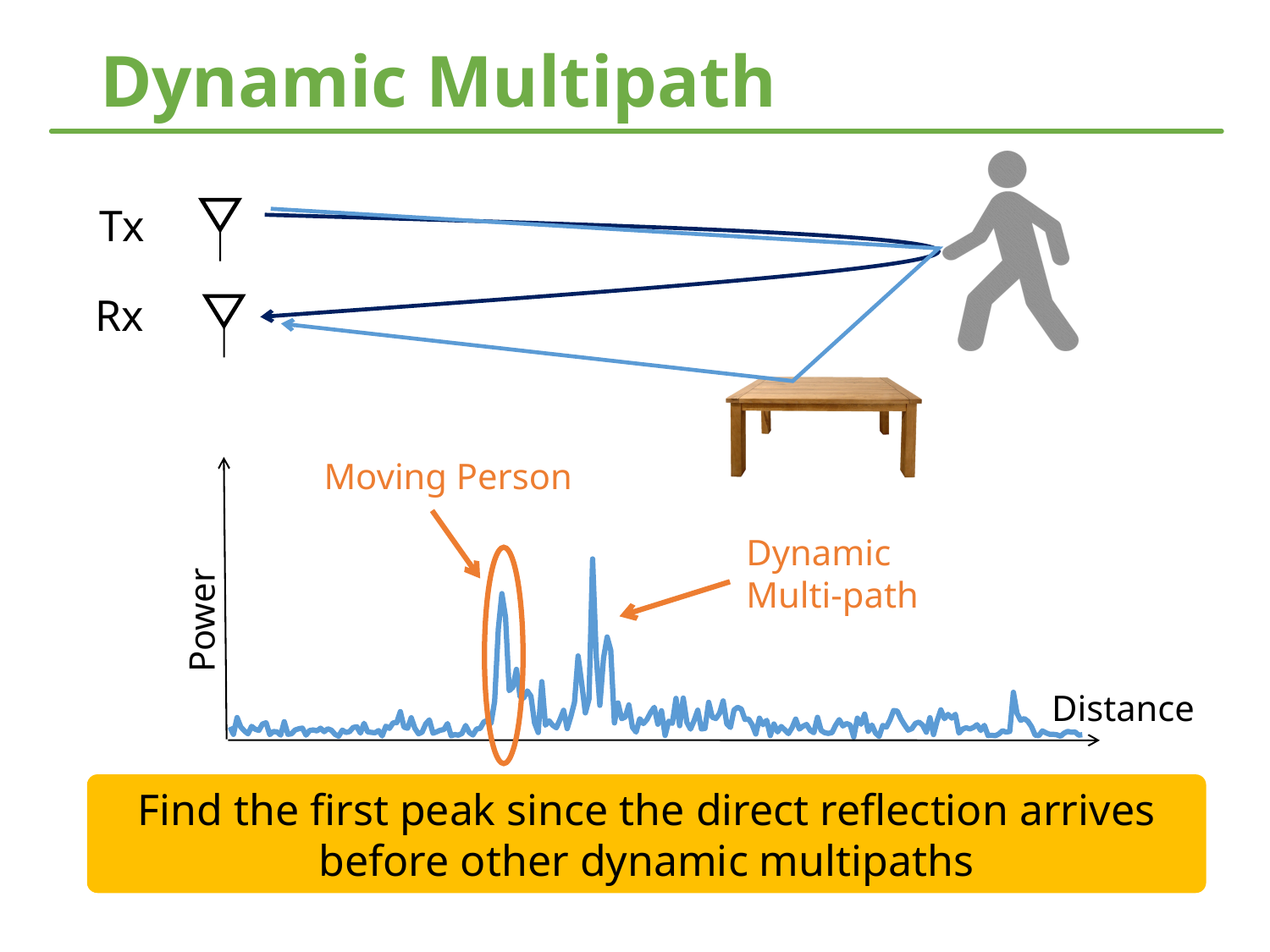
What label is attached to the peak circled in orange on the chart? Moving Person Which annotated peak appears first along the Distance axis, "Moving Person" or "Dynamic Multi-path"? Moving Person Which annotated peak is higher in the chart, the one labelled "Moving Person" or the one labelled "Dynamic Multi-path"? Dynamic Multi-path How many data series are plotted in the chart? 1 What kind of chart is shown at the bottom of the slide? Line chart What is the label on the vertical axis of the chart? Power What is the label on the horizontal axis of the chart? Distance